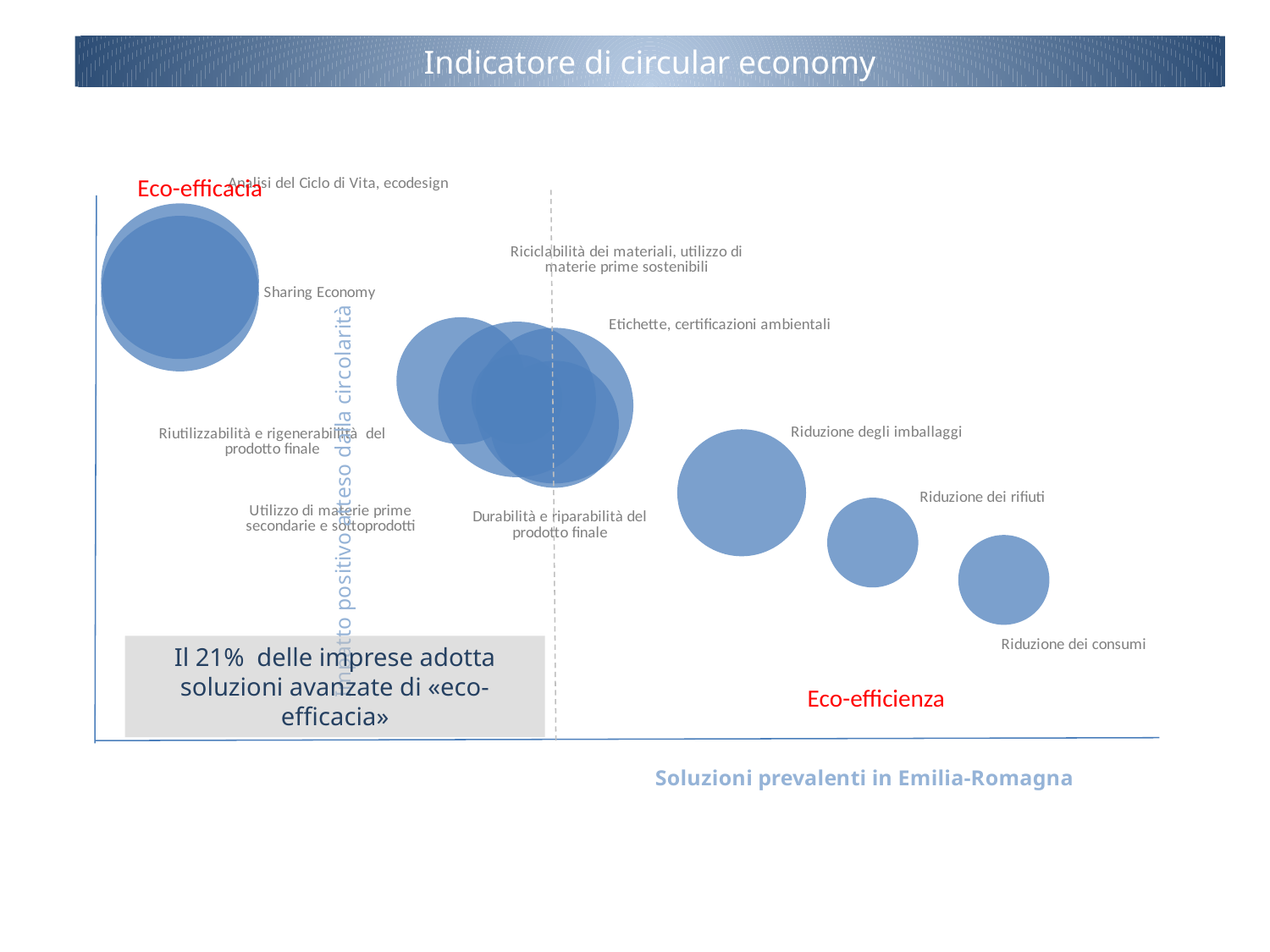
What is the title of the slide containing the chart? Indicatore di circular economy Which bubble is larger: 'Riduzione degli imballaggi' or 'Riduzione dei consumi'? Riduzione degli imballaggi Which labelled bubble is positioned highest on the vertical axis? Analisi del Ciclo di Vita, ecodesign According to the text box on the chart, what percentage of companies adopt advanced 'eco-efficacia' solutions? 21% What is the label on the vertical axis of the chart? Impatto positivo atteso dalla circolarità Which bubble is positioned further to the right: 'Riduzione degli imballaggi' or 'Riduzione dei consumi'? Riduzione dei consumi Which labelled bubble is positioned lowest on the vertical axis? Riduzione dei consumi What kind of chart is shown on the slide? Bubble chart Which bubble is positioned higher on the vertical axis: 'Sharing Economy' or 'Riduzione dei rifiuti'? Sharing Economy Do the bubbles generally rise or fall in vertical position moving from left to right along the x axis? Fall